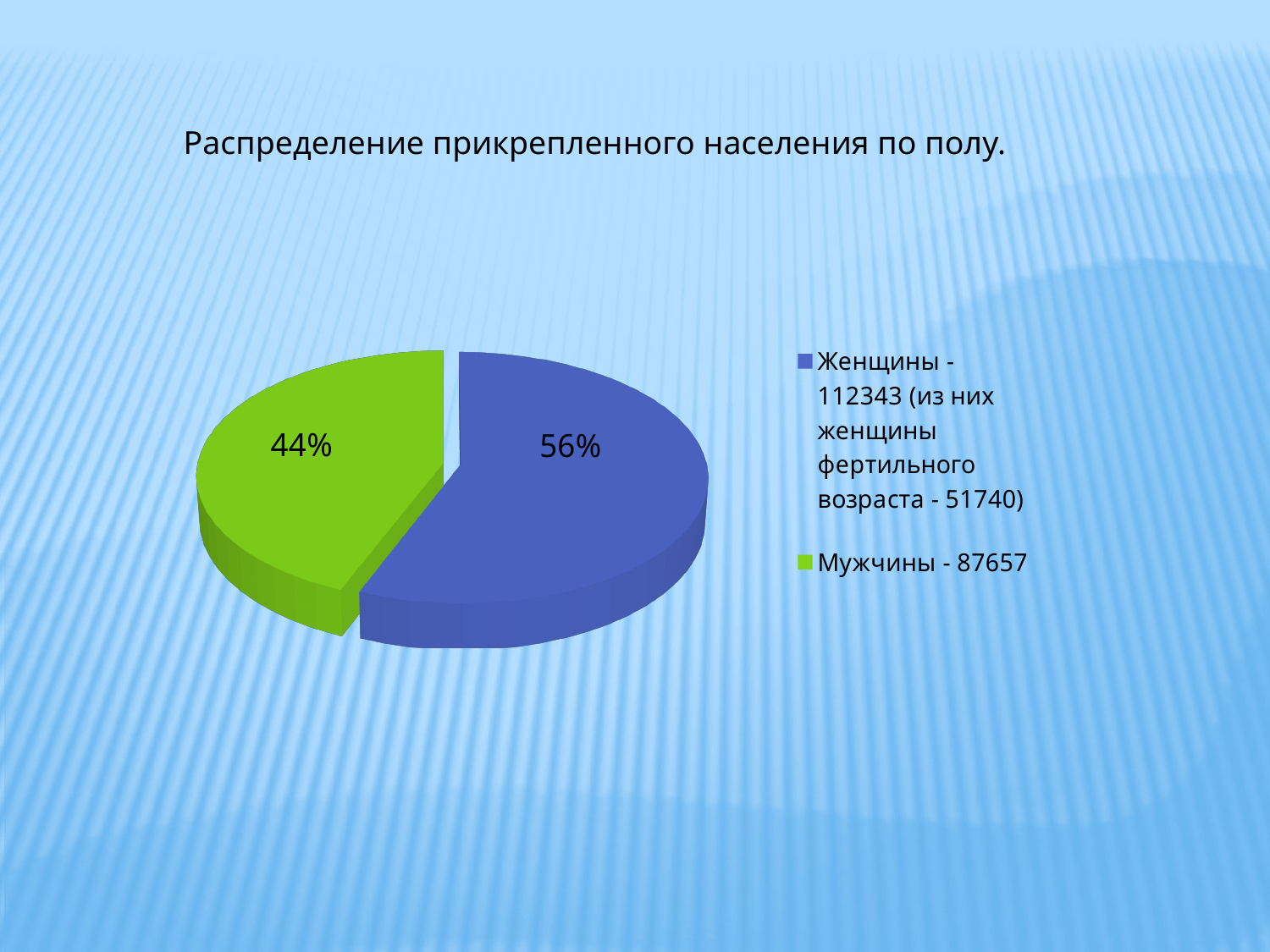
What share of the pie does the Женщины slice represent? 56% How many entries does the legend list? 2 According to the legend, how many Женщины are there? 112343 What share of the pie does the Мужчины slice represent? 44% What kind of chart is shown on the slide? pie chart Which category has the smallest slice of the pie? Мужчины Which category has the largest slice of the pie? Женщины According to the legend, how many Мужчины are there? 87657 How many slices does the pie chart have? 2 Which slice is larger, Женщины or Мужчины? Женщины What is the title of the chart? Распределение прикрепленного населения по полу. What is the difference in percentage points between the Женщины and Мужчины slices? 12